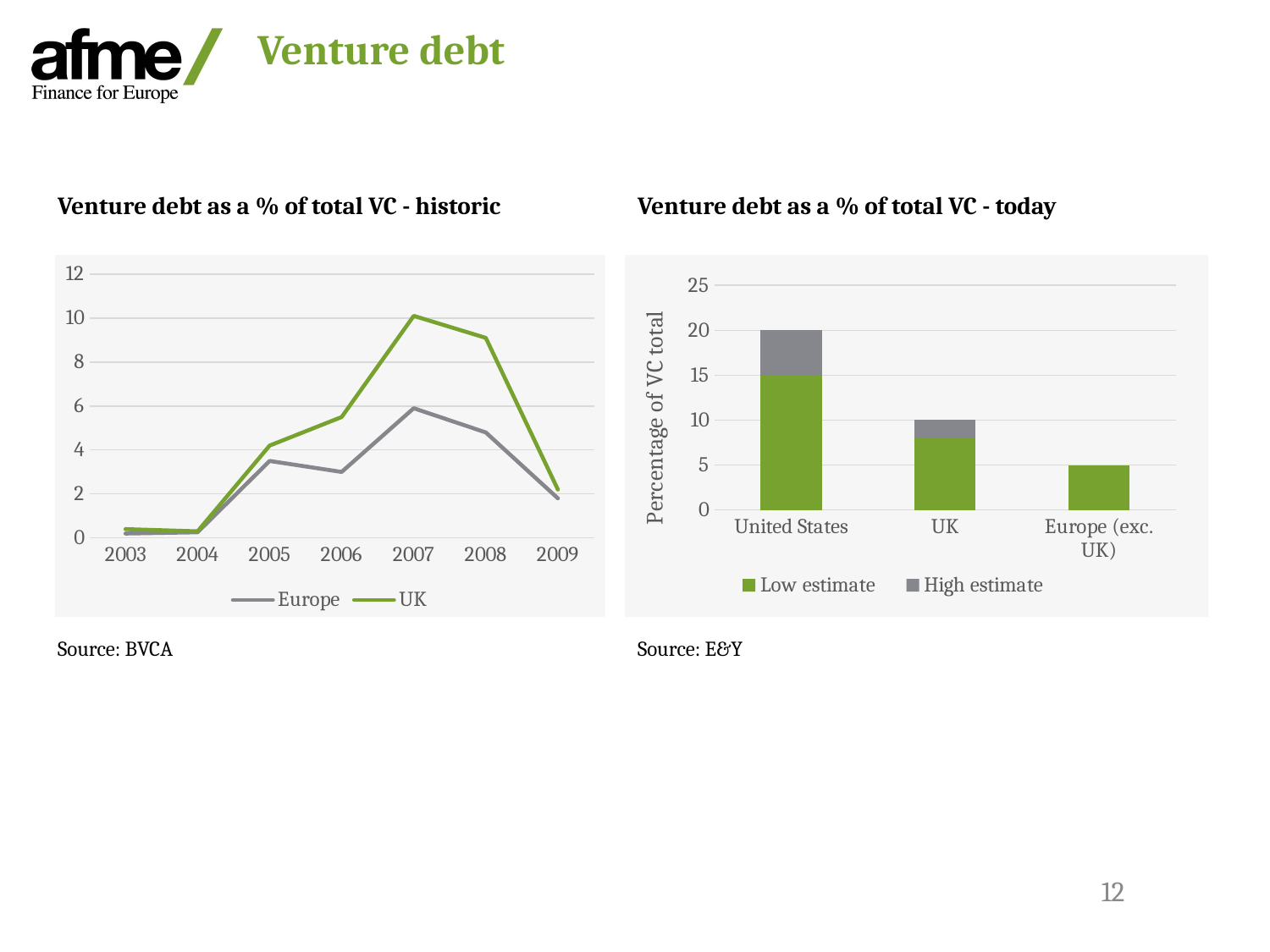
In the 'Venture debt as a % of total VC - today' chart, what is the Low estimate value for United States? 15 In the 'Venture debt as a % of total VC - historic' chart, does the UK line rise or fall from 2007 to 2009? Fall In the 'Venture debt as a % of total VC - historic' chart, in which year does the UK line reach its highest value? 2007 In the 'Venture debt as a % of total VC - historic' chart, is the Europe value for 2007 greater or less than 4? greater What kind of chart is the 'Venture debt as a % of total VC - today' chart? Bar chart In the 'Venture debt as a % of total VC - today' chart, what is the total height of the stacked bar for United States? 20 In the 'Venture debt as a % of total VC - today' chart, what is the label on the vertical axis? Percentage of VC total In the 'Venture debt as a % of total VC - today' chart, how many categories are shown on the x axis? 3 In the 'Venture debt as a % of total VC - historic' chart, how many years are plotted on the x axis? 7 In the 'Venture debt as a % of total VC - historic' chart, is the UK value for 2007 greater or less than 8? greater In the 'Venture debt as a % of total VC - historic' chart, how many series does the legend list? 2 What kind of chart is the 'Venture debt as a % of total VC - historic' chart? Line chart